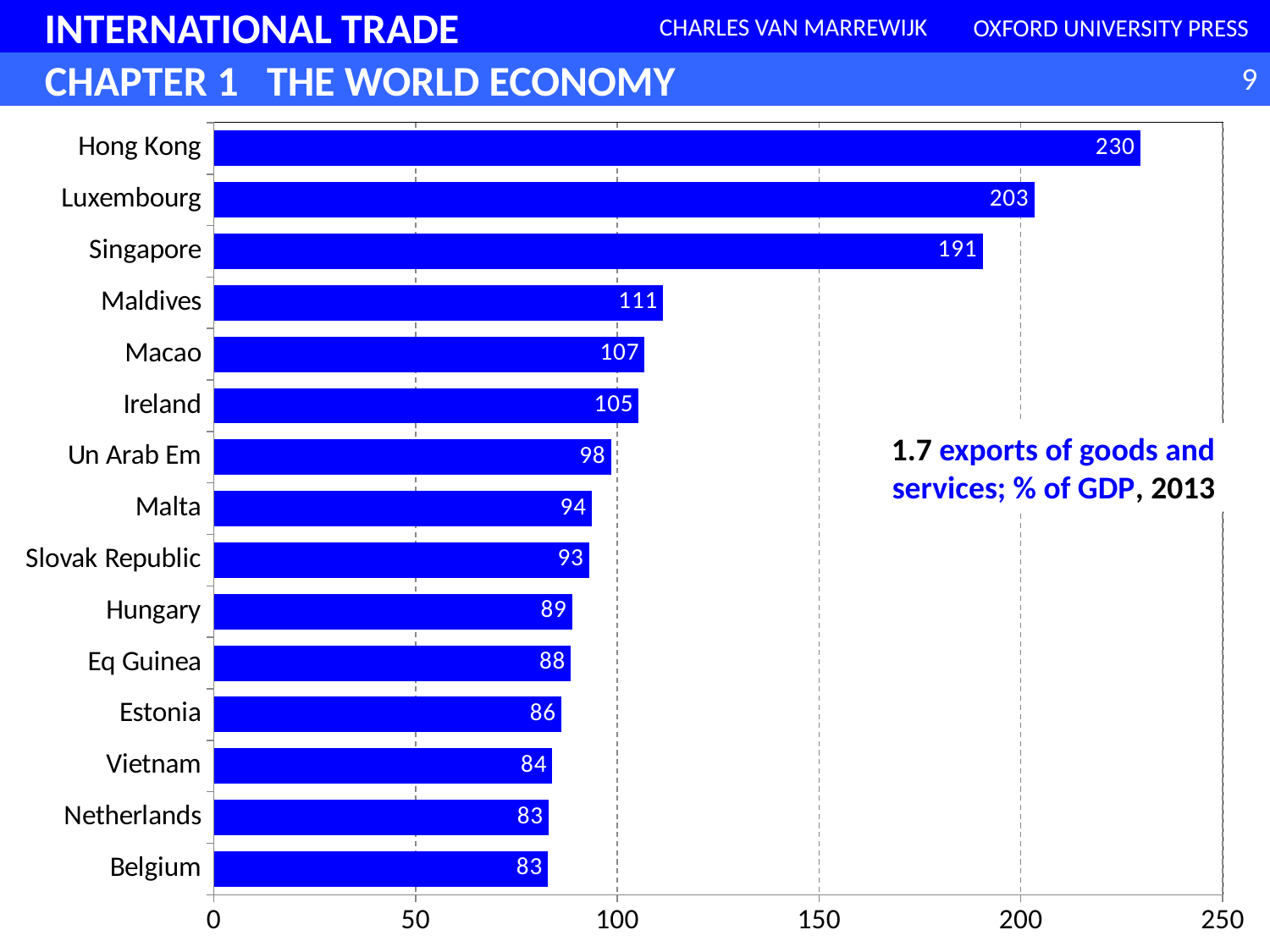
What is the difference between the values for Maldives and Ireland? 6 Which country has the highest exports as % of GDP? Hong Kong What is the value for Singapore? 191 How many countries are shown on the chart? 15 What kind of chart is shown on the slide? bar chart Is the value for Luxembourg greater or less than 200? greater What year does the chart's data refer to? 2013 What is the value for Hong Kong? 230 Which is larger, the value for Macao or the value for Malta? Macao Which country has the lowest value shown on the chart? Belgium and Netherlands (both 83) What is the difference between the values for Hong Kong and Luxembourg? 27 What is the value for Slovak Republic? 93